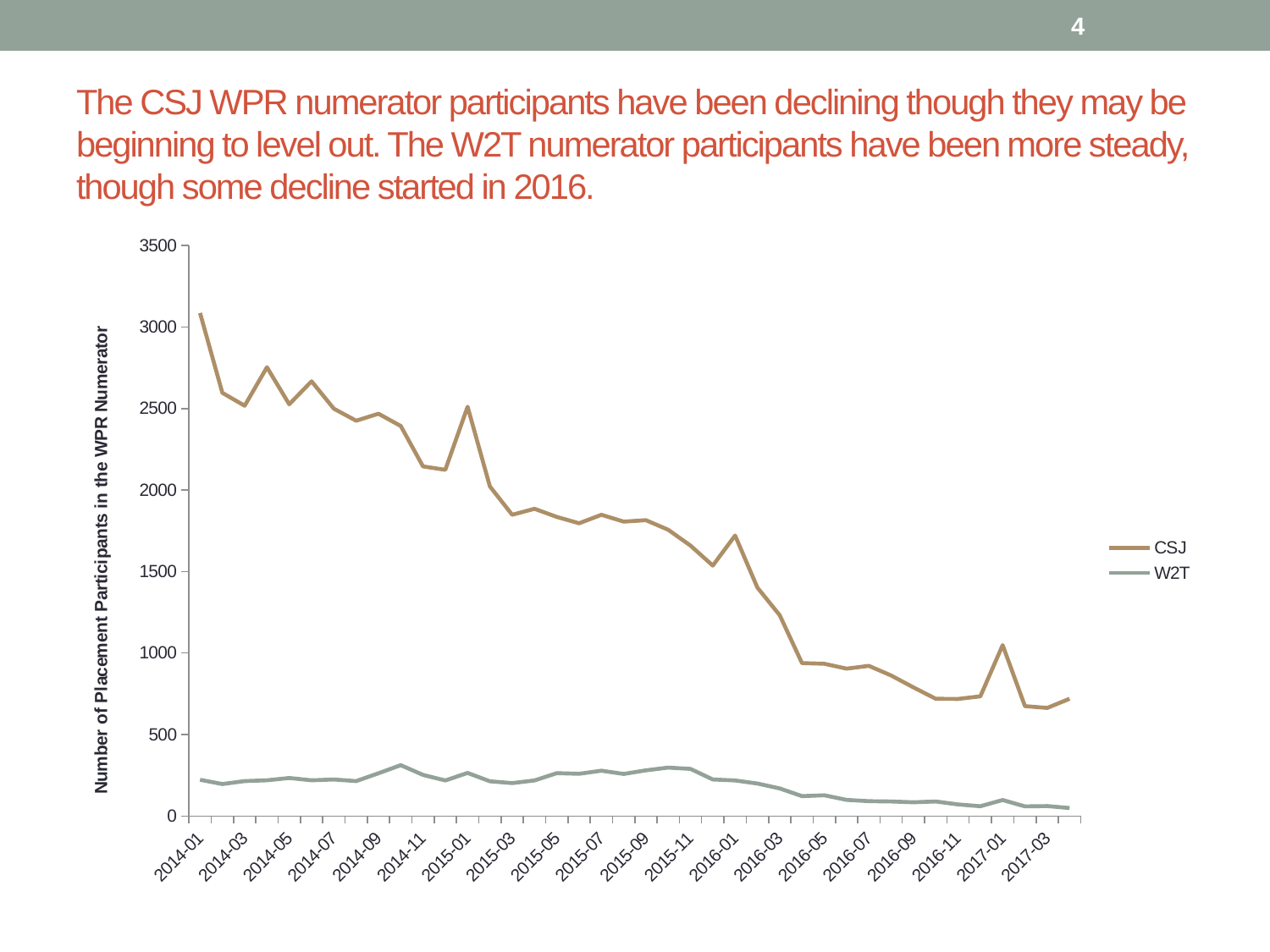
How many series does the legend list? 2 Which series stays lower than the other across the whole period, CSJ or W2T? W2T At which x-axis label does the CSJ series reach its highest value? 2014-01 Does the CSJ line generally rise or fall from 2014-01 to 2017-03? fall Is the CSJ value at 2014-01 greater or less than 2500? greater Is the CSJ value at 2016-01 greater or less than 1500? greater What is the title of the vertical axis? Number of Placement Participants in the WPR Numerator Is the CSJ value at 2017-03 greater or less than 1000? less What are the two series named in the legend? CSJ and W2T What kind of chart is shown on the slide? line chart Which series has the higher value at 2014-01, CSJ or W2T? CSJ